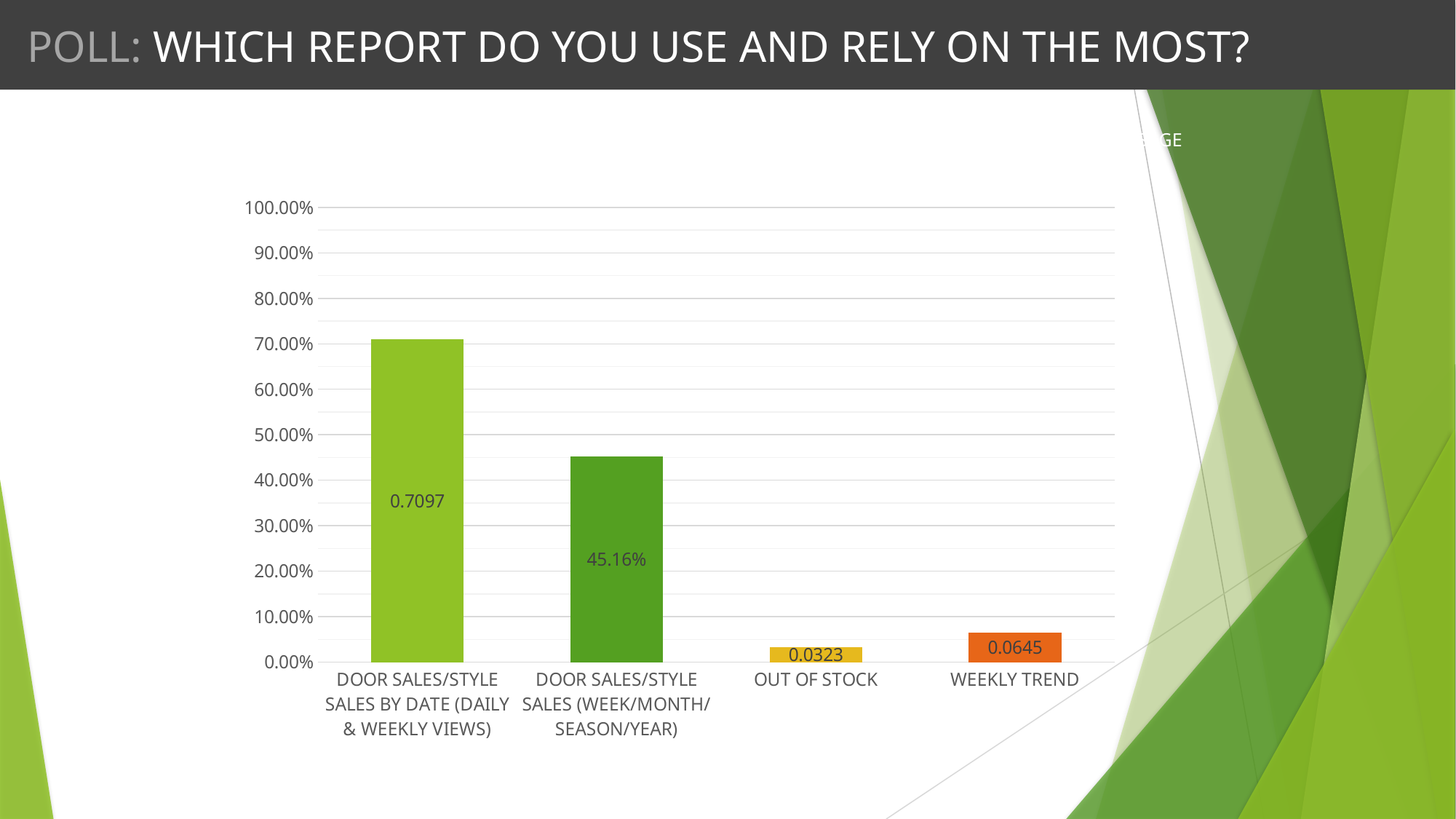
Which category has the lowest bar? OUT OF STOCK What is the data label shown on the bar for DOOR SALES/STYLE SALES BY DATE (DAILY & WEEKLY VIEWS)? 0.7097 What kind of chart is shown on the slide? bar chart What is the data label shown on the bar for DOOR SALES/STYLE SALES (WEEK/MONTH/SEASON/YEAR)? 45.16% What is the data label shown on the bar for OUT OF STOCK? 0.0323 What colour is the bar for WEEKLY TREND? orange Is the value for DOOR SALES/STYLE SALES (WEEK/MONTH/SEASON/YEAR) greater or less than 50.00%? less What is the data label shown on the bar for WEEKLY TREND? 0.0645 Is the value for DOOR SALES/STYLE SALES BY DATE (DAILY & WEEKLY VIEWS) greater or less than 60.00%? greater How many categories are plotted in the chart? 4 Which category has the highest bar? DOOR SALES/STYLE SALES BY DATE (DAILY & WEEKLY VIEWS) Which is larger, the bar for WEEKLY TREND or the bar for OUT OF STOCK? WEEKLY TREND